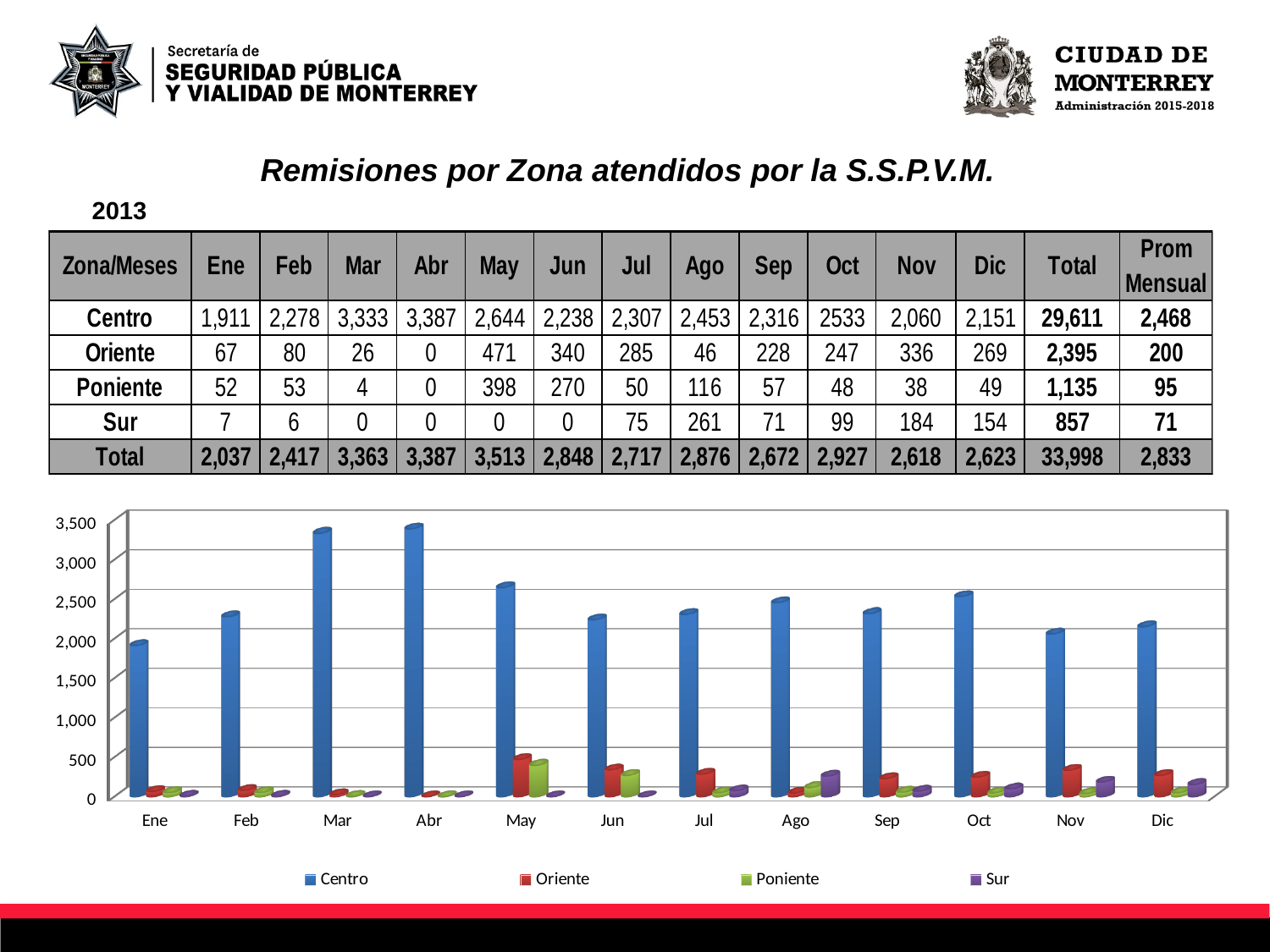
What is the value for Sur in Ago? 261 What is the value for Centro in Abr? 3,387 Which series is shown in blue in the chart legend? Centro Which is larger in May, the Oriente value or the Poniente value? Oriente Is the value for Centro in Oct greater or less than 2,500? greater How many series does the chart legend list? 4 In which month is the Centro value highest? Abr How many months are shown along the x axis of the chart? 12 What is the value for Oriente in May? 471 What is the difference between the Centro values for Mar and Feb? 1,055 In which month is the Centro value lowest? Ene What kind of chart is shown on the slide? bar chart